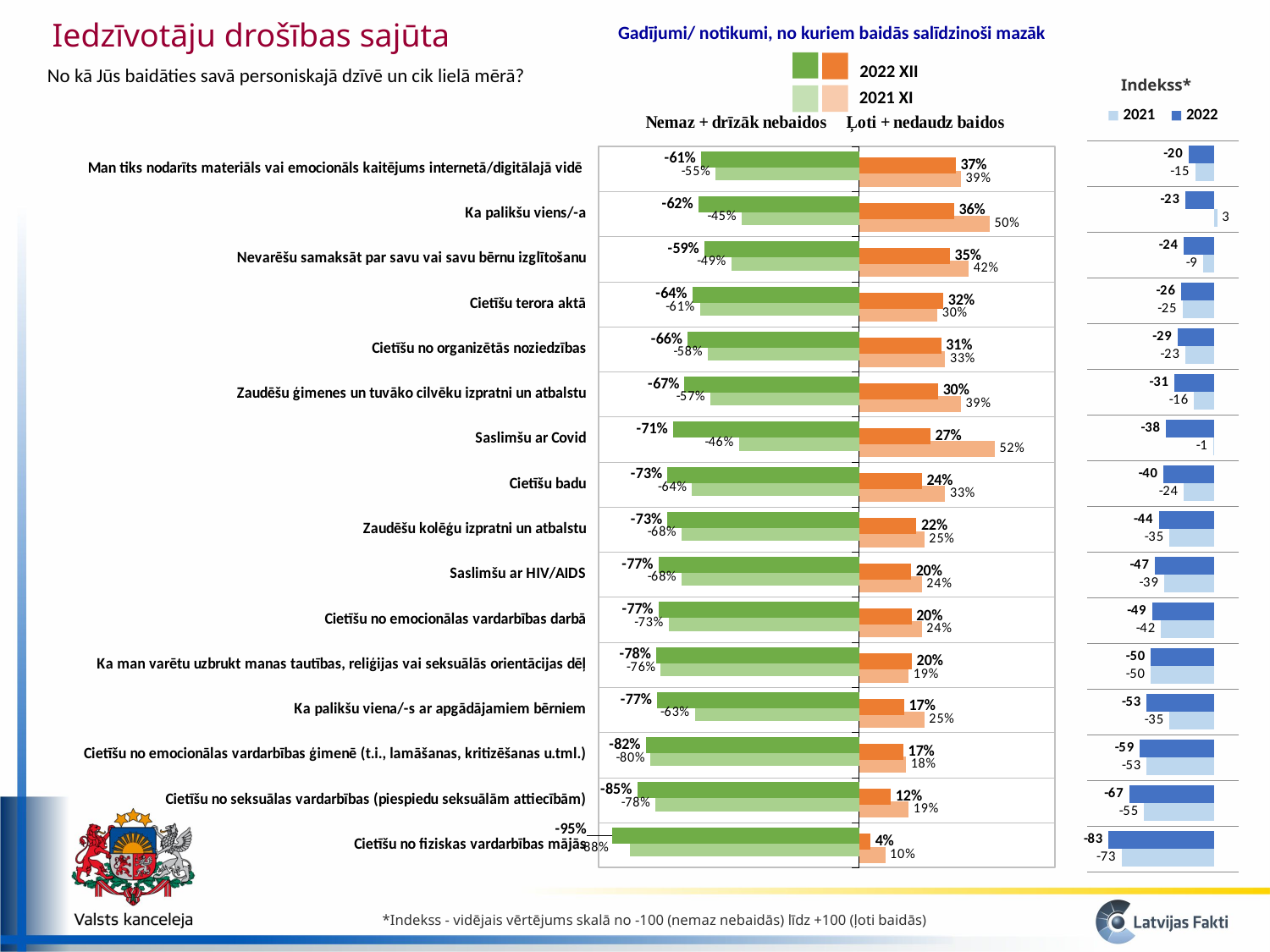
In the Indekss* chart, what is the 2022 index value for 'Cietīšu no fiziskas vardarbības mājās'? -83 In the main chart, what is the 2021 XI share of 'Ļoti + nedaudz baidos' for 'Ka palikšu viens/-a'? 50% How many series does the legend of the main chart list? 2 In the main chart, which category has the highest 2022 XII share of 'Ļoti + nedaudz baidos'? Man tiks nodarīts materiāls vai emocionāls kaitējums internetā/digitālajā vidē In the Indekss* chart, what is the 2021 index value for 'Ka palikšu viens/-a'? 3 In the main chart, what is the 2022 XII share of 'Ļoti + nedaudz baidos' for 'Saslimšu ar Covid'? 27% In the main chart, what is the 2022 XII value of 'Nemaz + drīzāk nebaidos' for 'Cietīšu terora aktā'? -64% In the main chart, which category has the lowest 2022 XII share of 'Ļoti + nedaudz baidos'? Cietīšu no fiziskas vardarbības mājās How many categories (fears) are listed in the main chart? 16 What kind of chart is the main chart? bar chart In the main chart, is the 2022 XII 'Ļoti + nedaudz baidos' share for 'Cietīšu badu' larger or smaller than the 2021 XI share? smaller In the main chart, what is the difference between the 2021 XI and 2022 XII 'Ļoti + nedaudz baidos' shares for 'Saslimšu ar Covid'? 25 percentage points